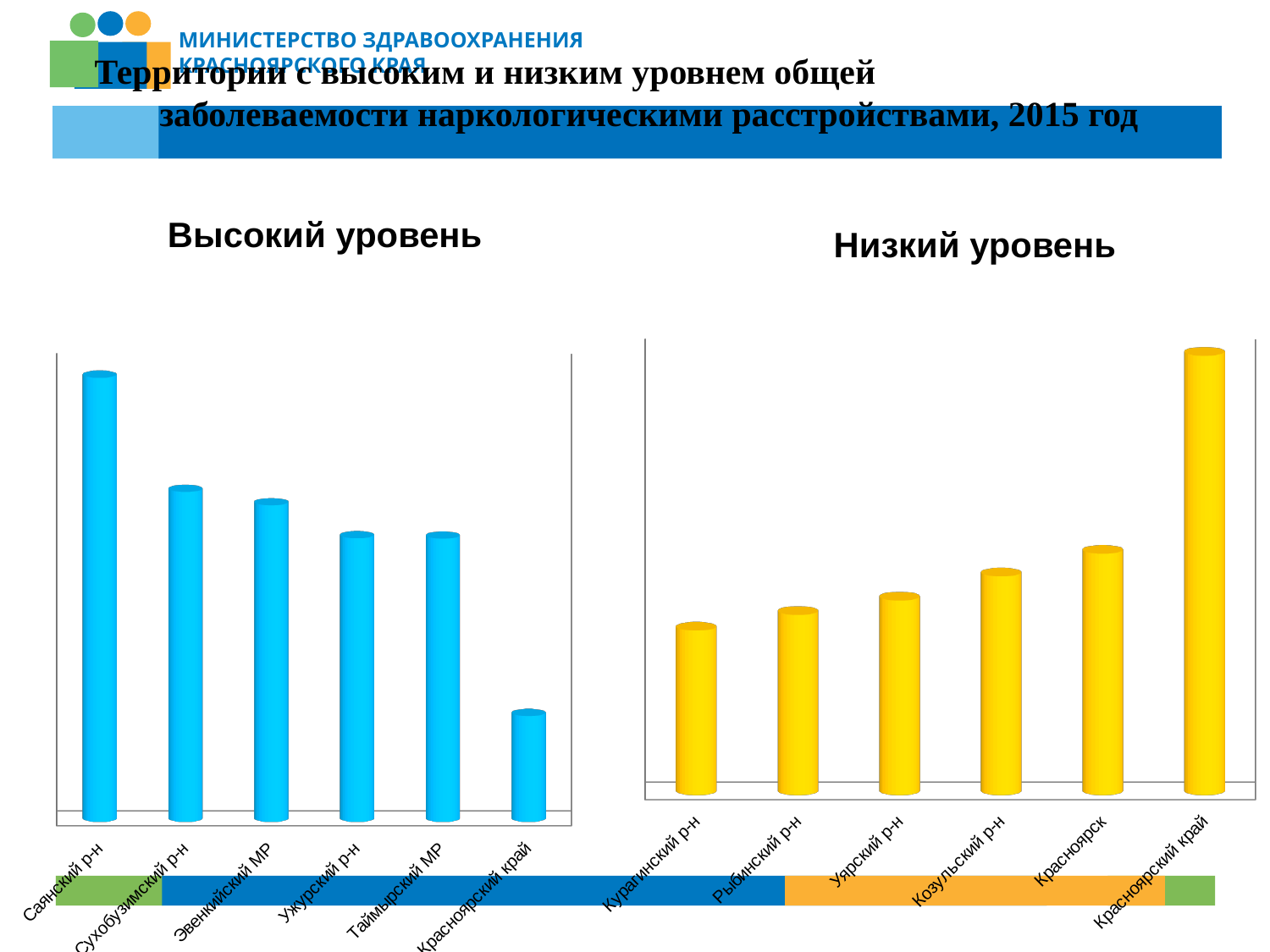
In the 'Высокий уровень' chart, which is larger: the value for Саянский р-н or the value for Ужурский р-н? Саянский р-н In the 'Высокий уровень' chart, which territory has the lowest bar? Красноярский край How many territories are shown in the 'Низкий уровень' chart? 6 In the 'Низкий уровень' chart, which territory has the highest bar? Красноярский край How many territories are shown in the 'Высокий уровень' chart? 6 In the 'Высокий уровень' chart, which territory has the highest bar? Саянский р-н What kind of chart is the 'Низкий уровень' chart on the right? bar chart In the 'Низкий уровень' chart, which territory has the lowest bar? Курагинский р-н In the 'Низкий уровень' chart, do the values rise or fall from left to right? rise In the 'Низкий уровень' chart, which is larger: the value for Красноярск or the value for Рыбинский р-н? Красноярск What kind of chart is the 'Высокий уровень' chart on the left? bar chart What colour are the bars in the 'Низкий уровень' chart? yellow